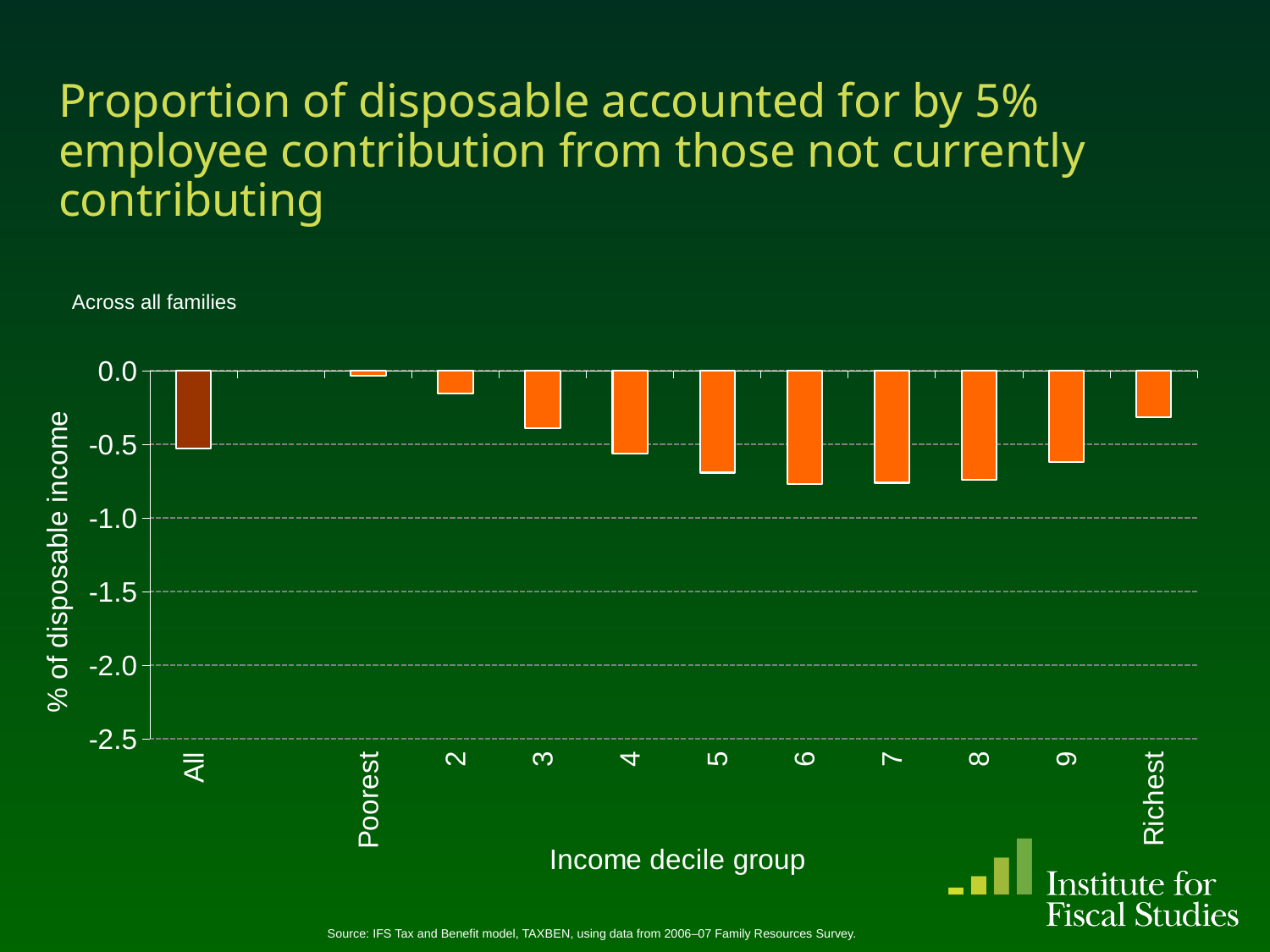
How many categories are shown on the x axis of the chart? 11 Which category has the highest value (closest to zero) in the chart? Poorest Is the value for income decile 8 greater or less than -1.0? greater What kind of chart is shown on the slide? bar chart Which bar extends further below zero, income decile 3 or income decile 6? 6 Do the values rise or fall moving along the x axis from Poorest to income decile 6? fall Is the value for income decile 5 greater or less than -0.5? less Is the value for income decile 6 greater or less than -0.5? less What is the label on the y axis of the chart? % of disposable income Which bar extends further below zero, Poorest or Richest? Richest